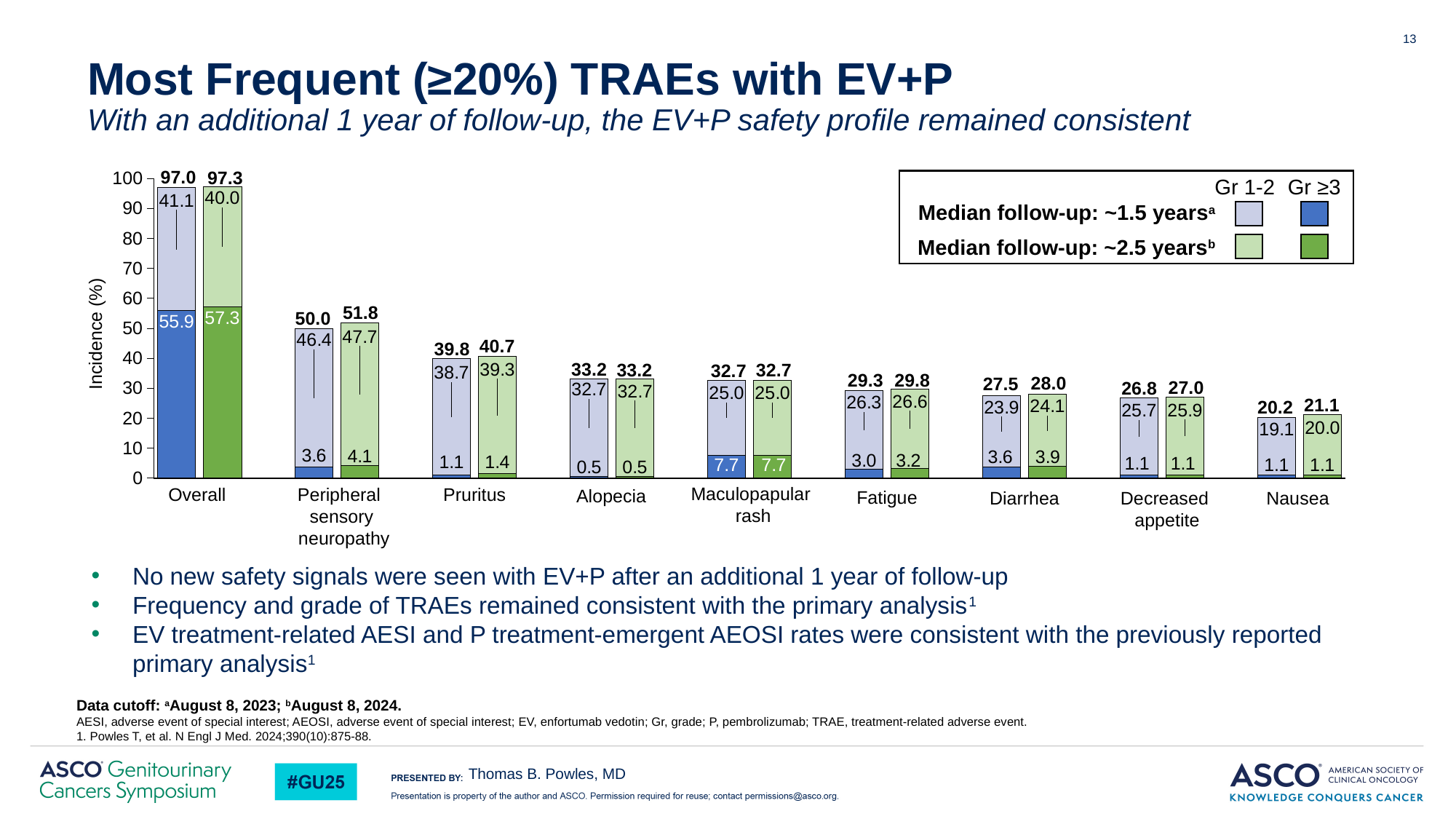
What is the Gr 1-2 incidence for Peripheral sensory neuropathy at the ~2.5 years median follow-up? 47.7 What is the Gr ≥3 incidence for Alopecia at the ~2.5 years median follow-up? 0.5 How many adverse event categories are shown on the x axis? 9 What is the y-axis label of the chart? Incidence (%) Which category has the highest total incidence? Overall What is the Gr ≥3 incidence for Overall at the ~1.5 years median follow-up? 55.9 What kind of chart is shown on the slide? Stacked bar chart What is the total incidence for Overall at the ~2.5 years median follow-up? 97.3 Which category has the lowest total incidence at the ~2.5 years median follow-up? Nausea At the ~2.5 years median follow-up, which has the larger Gr ≥3 incidence: Fatigue or Diarrhea? Diarrhea What is the difference between the total incidence for Pruritus at ~2.5 years and at ~1.5 years? 0.9 How many entries does the legend list? 4